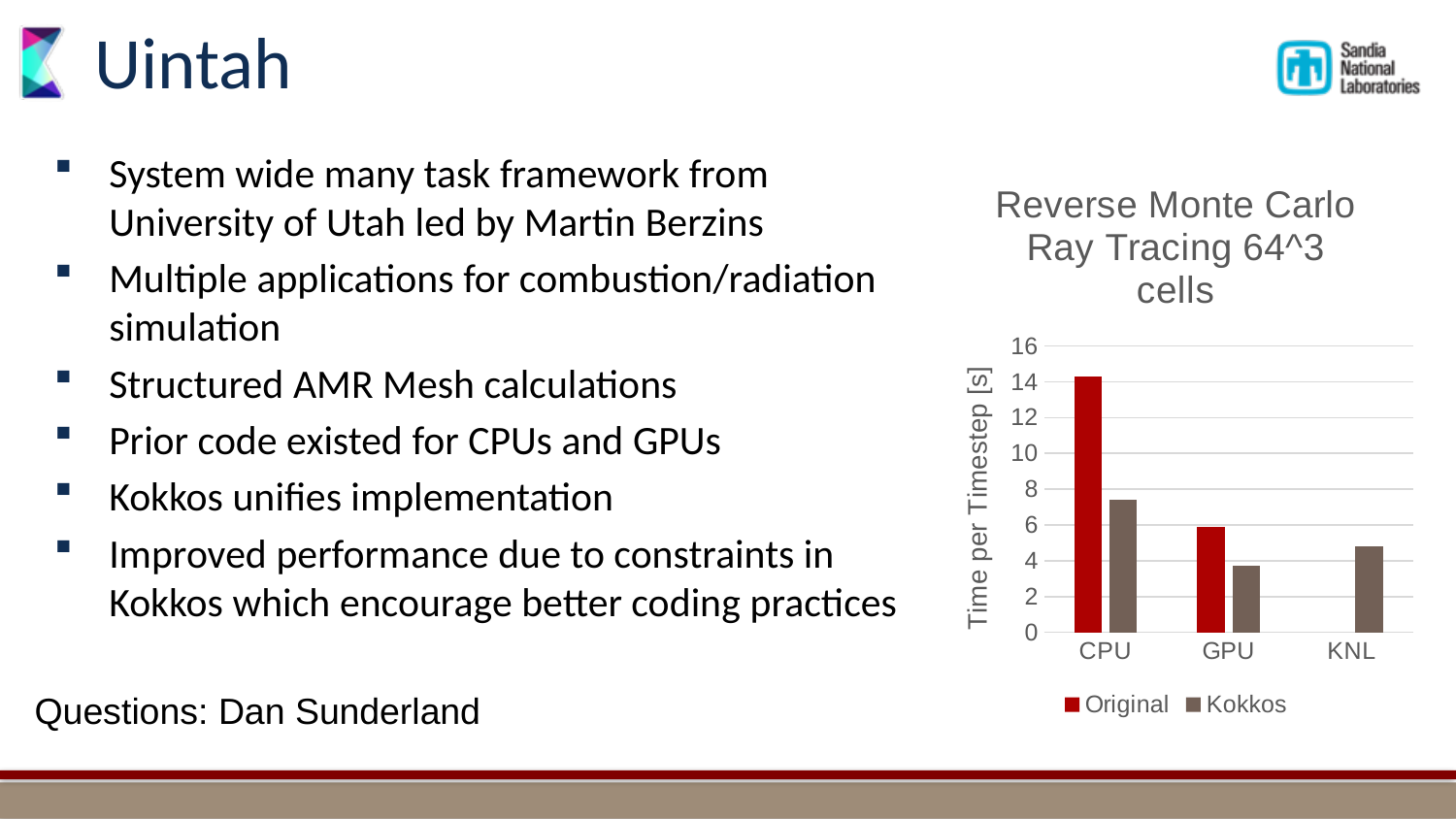
What is the title of the chart? Reverse Monte Carlo Ray Tracing 64^3 cells How many categories are shown on the x axis of the chart? 3 What is the label of the vertical axis of the chart? Time per Timestep [s] Is the Kokkos value for CPU greater or less than 8? less Is the Kokkos value for KNL greater or less than 6? less Is the Original value for CPU greater or less than 12? greater How many series does the chart legend list? 2 What kind of chart is shown on the slide? bar chart For CPU, which is larger: the Original value or the Kokkos value? Original Which category has the highest Original value? CPU Which category has the lowest Kokkos value? GPU